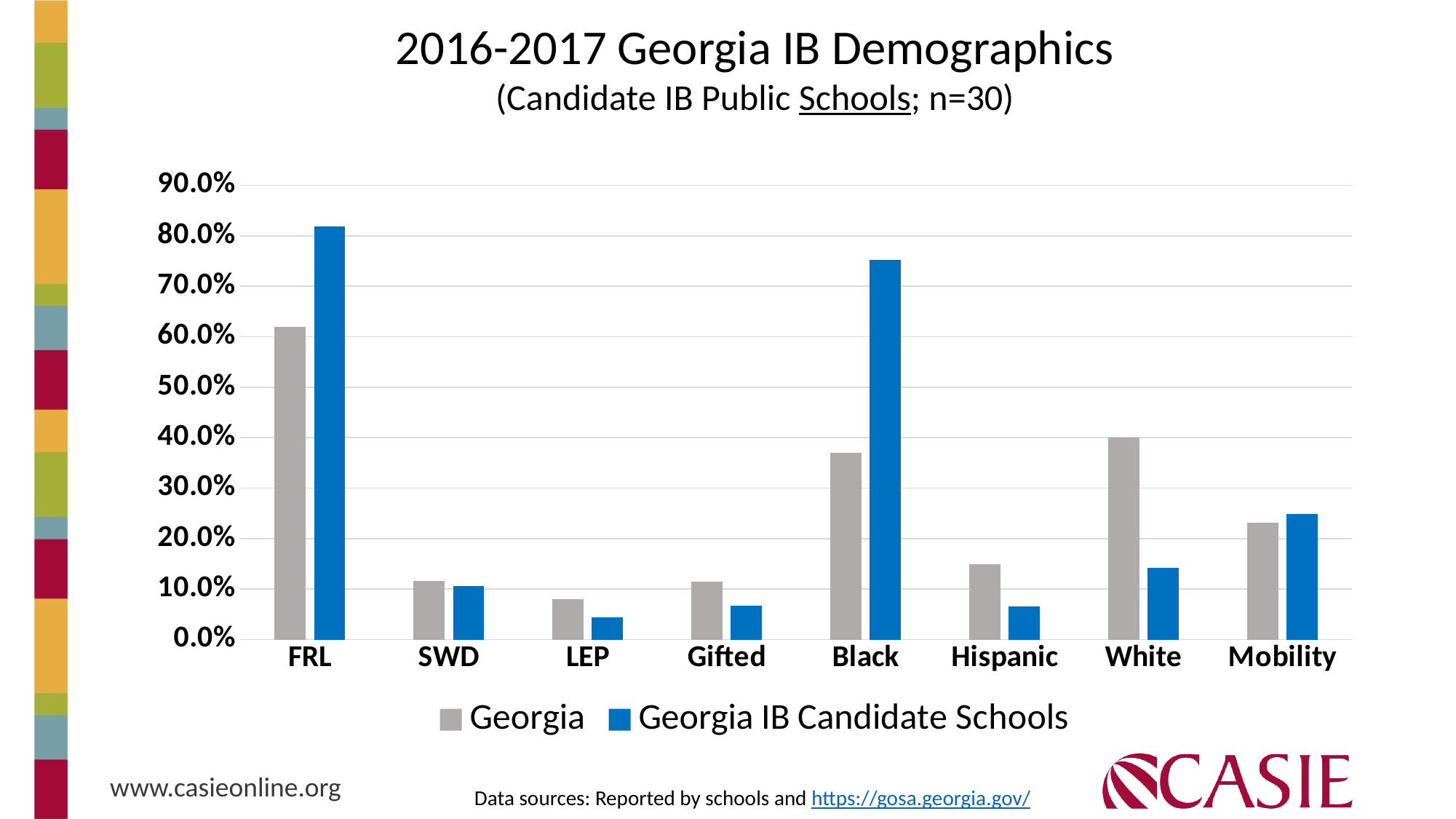
What kind of chart is shown on the slide? bar chart Is the value for Georgia IB Candidate Schools in the Black category greater or less than 70.0%? greater What colour are the bars for the Georgia IB Candidate Schools series? blue For the White category, which series has the larger value, Georgia or Georgia IB Candidate Schools? Georgia How many series does the legend list? 2 Which category has the highest value for the Georgia series? FRL Which category has the highest value for Georgia IB Candidate Schools? FRL For the Black category, which series has the larger value, Georgia or Georgia IB Candidate Schools? Georgia IB Candidate Schools How many categories are shown on the x axis? 8 Is the value for Georgia in the Hispanic category greater or less than 20.0%? less Which category has the lowest value for the Georgia series? LEP Which category has the lowest value for Georgia IB Candidate Schools? LEP